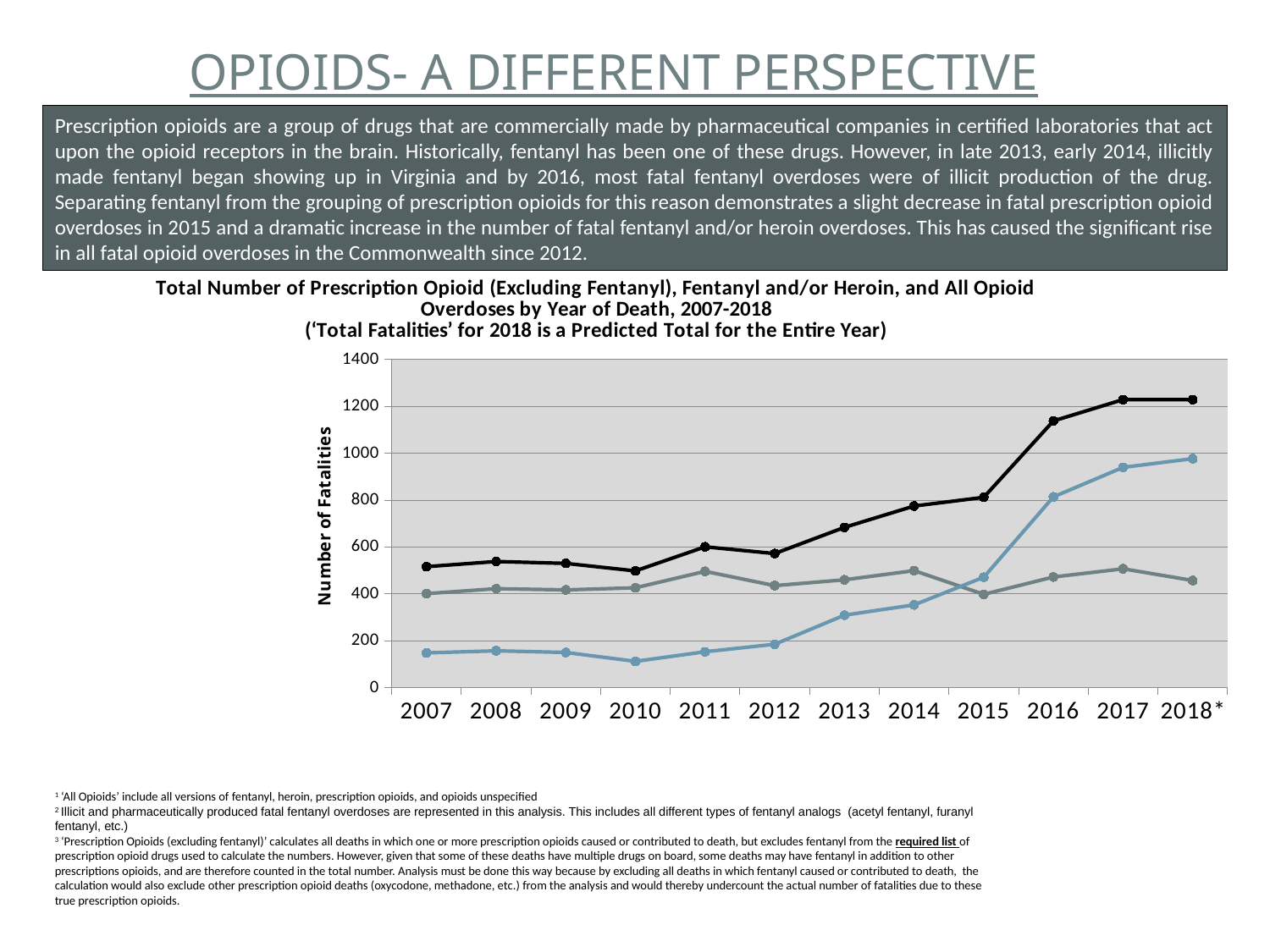
How many lines are plotted on the chart? 3 What is the label of the y axis of the chart? Number of Fatalities Which year is marked with an asterisk on the x axis of the chart? 2018* Is the value of the blue line for 2010 greater or less than 200? less In which year does the blue line reach its lowest value? 2010 Does the blue line rise or fall from 2012 to 2018*? rise Is the value of the black line for 2018* greater or less than 1000? greater What kind of chart is shown on the slide? line chart How many years are shown along the x axis of the chart? 12 Is the value of the blue line for 2016 greater or less than 600? greater In 2012, which line has the larger value, the blue line or the gray line? the gray line